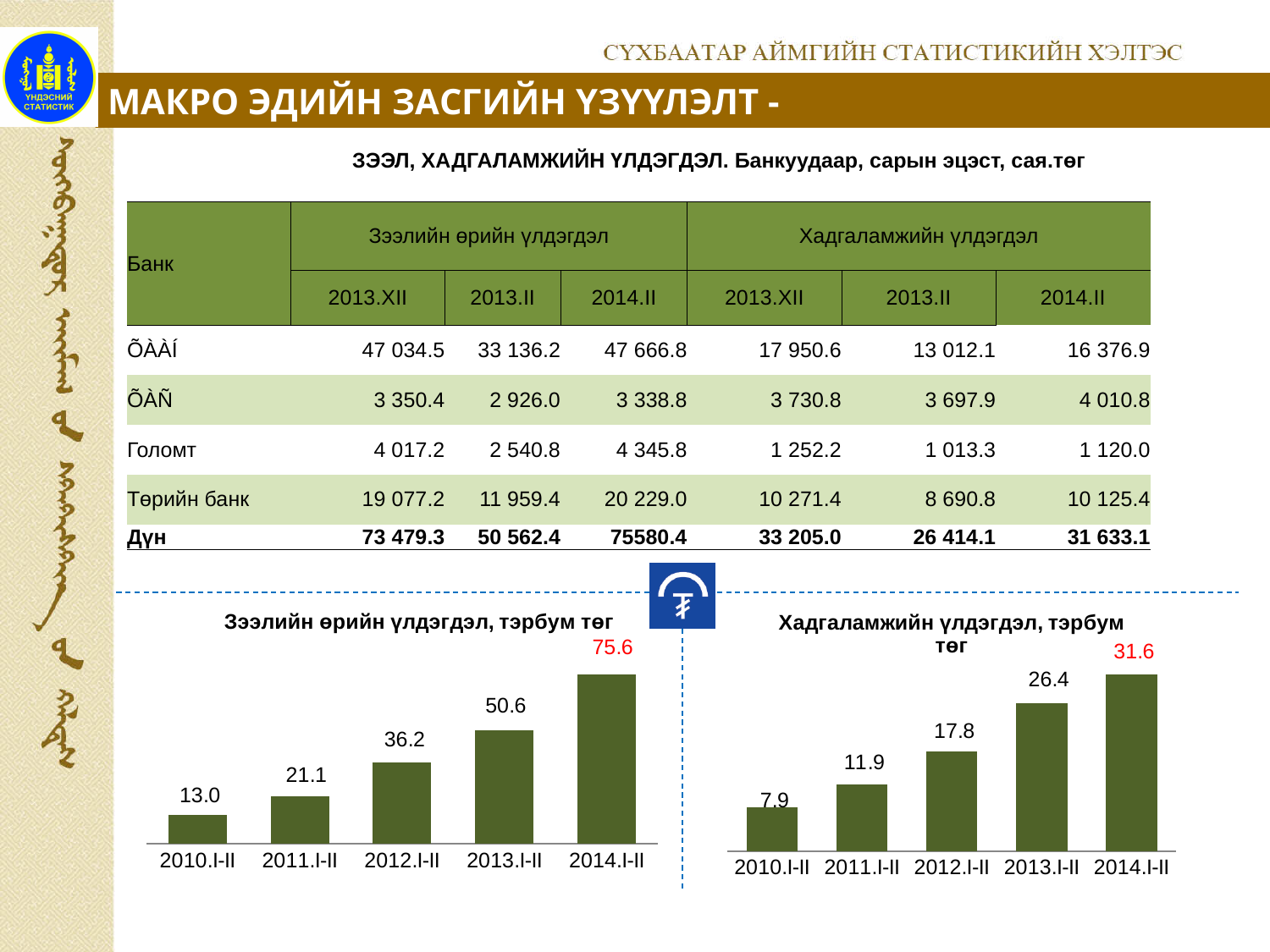
How many periods are shown on the x axis of the chart titled 'Хадгаламжийн үлдэгдэл, тэрбум төг'? 5 In the chart titled 'Зээлийн өрийн үлдэгдэл, тэрбум төг', what is the value for 2014.I-II? 75.6 In the chart titled 'Зээлийн өрийн үлдэгдэл, тэрбум төг', which period has the lowest value? 2010.I-II In the chart titled 'Хадгаламжийн үлдэгдэл, тэрбум төг', do the values rise or fall from 2010.I-II to 2014.I-II? Rise In the chart titled 'Хадгаламжийн үлдэгдэл, тэрбум төг', what is the value for 2011.I-II? 11.9 In the chart titled 'Зээлийн өрийн үлдэгдэл, тэрбум төг', what is the difference between the values for 2014.I-II and 2013.I-II? 25.0 In the chart titled 'Хадгаламжийн үлдэгдэл, тэрбум төг', what is the difference between the values for 2012.I-II and 2010.I-II? 9.9 In the chart titled 'Зээлийн өрийн үлдэгдэл, тэрбум төг', what is the value for 2012.I-II? 36.2 What kind of chart is the chart titled 'Зээлийн өрийн үлдэгдэл, тэрбум төг'? Bar chart In the chart titled 'Хадгаламжийн үлдэгдэл, тэрбум төг', which period has the highest value? 2014.I-II In the chart titled 'Хадгаламжийн үлдэгдэл, тэрбум төг', what is the value for 2013.I-II? 26.4 Which is larger: the 2013.I-II value in the chart titled 'Зээлийн өрийн үлдэгдэл, тэрбум төг' or the 2014.I-II value in the chart titled 'Хадгаламжийн үлдэгдэл, тэрбум төг'? 2013.I-II in 'Зээлийн өрийн үлдэгдэл, тэрбум төг' (50.6)